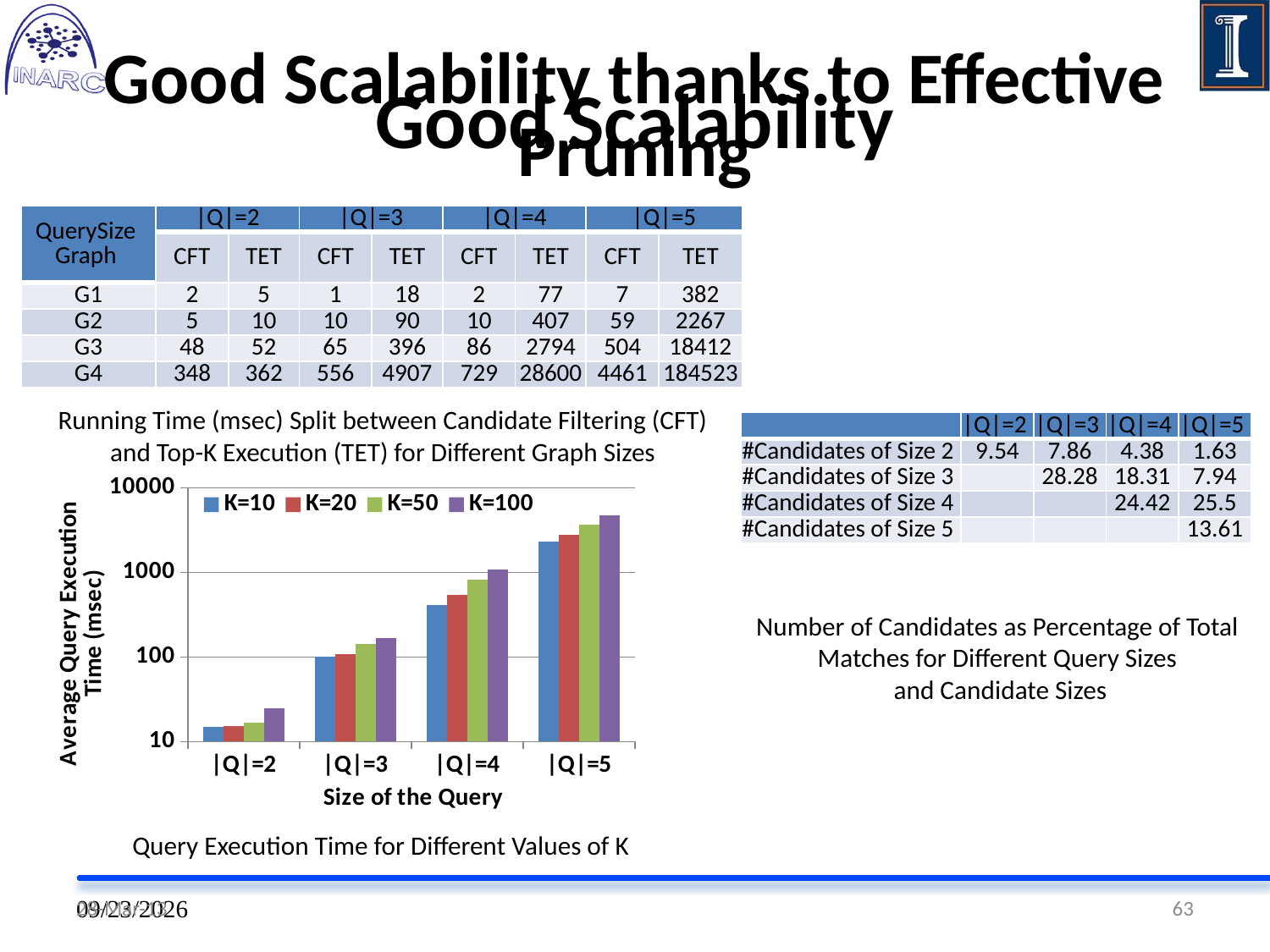
Is the value for K=100 at |Q|=3 greater or less than 100? greater At |Q|=4, which is larger: the K=10 bar or the K=100 bar? K=100 What kind of chart is shown on the slide? bar chart Is the value for K=100 at |Q|=5 greater or less than 10000? less For which query size is the K=100 bar the highest? |Q|=5 How many query-size categories are shown on the x axis of the chart? 4 Does the average query execution time rise or fall as the size of the query increases from |Q|=2 to |Q|=5? rise What is the label of the x axis of the chart? Size of the Query What is the label of the y axis of the chart? Average Query Execution Time (msec) For which query size is the K=10 bar the lowest? |Q|=2 Is the value for K=10 at |Q|=4 greater or less than 1000? less How many series does the chart legend list? 4